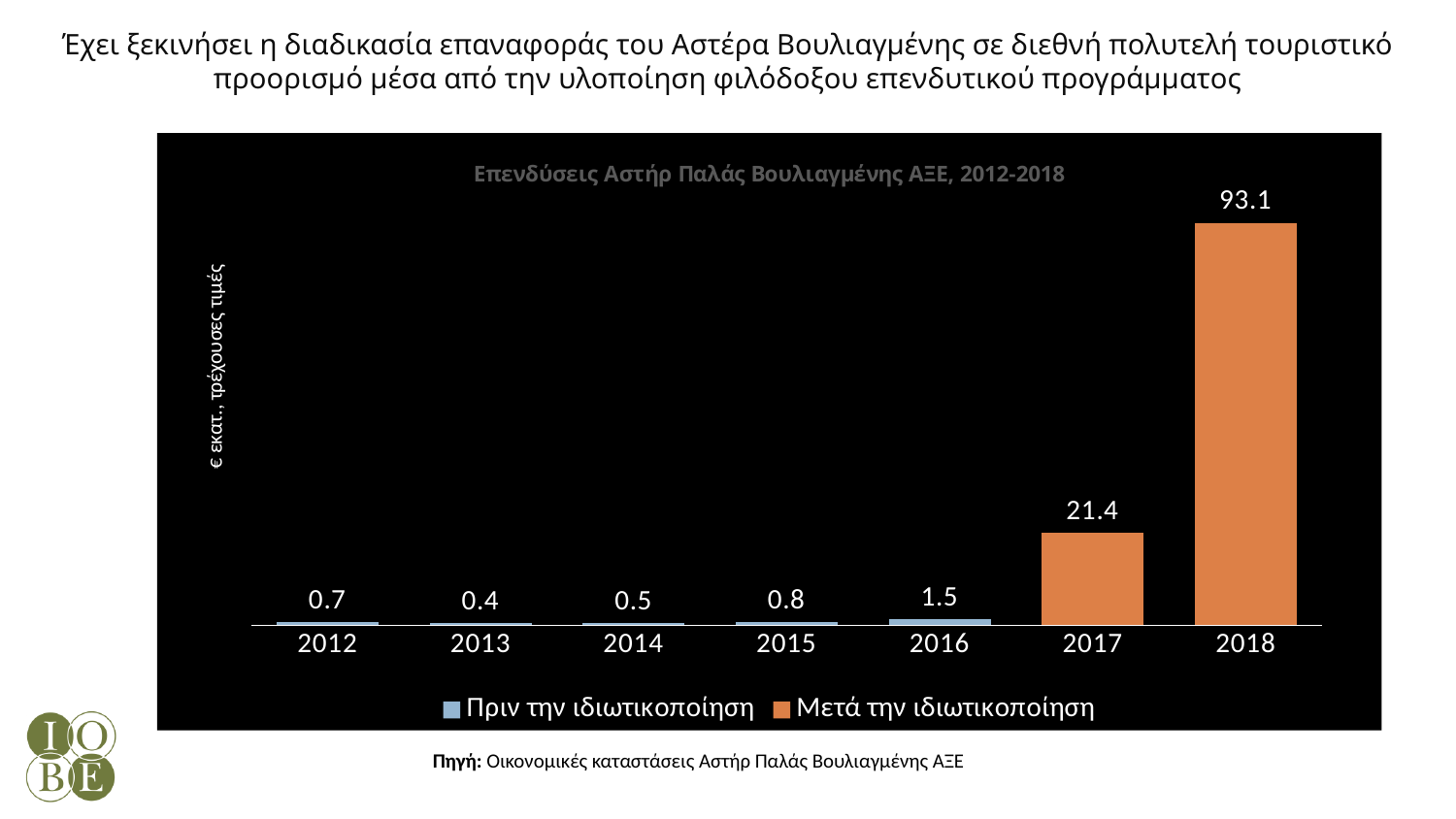
Which series does the 2018 bar belong to, according to the legend? Μετά την ιδιωτικοποίηση Which year has the highest value? 2018 What is the value for 2018? 93.1 What is the value for 2017? 21.4 Which is larger, the value for 2015 or the value for 2014? 2015 How many years are shown on the x axis? 7 Which year has the lowest value? 2013 What is the difference between the values for 2018 and 2017? 71.7 What is the value for 2016? 1.5 What kind of chart is shown? bar chart How many series does the legend list? 2 What is the value for 2013? 0.4